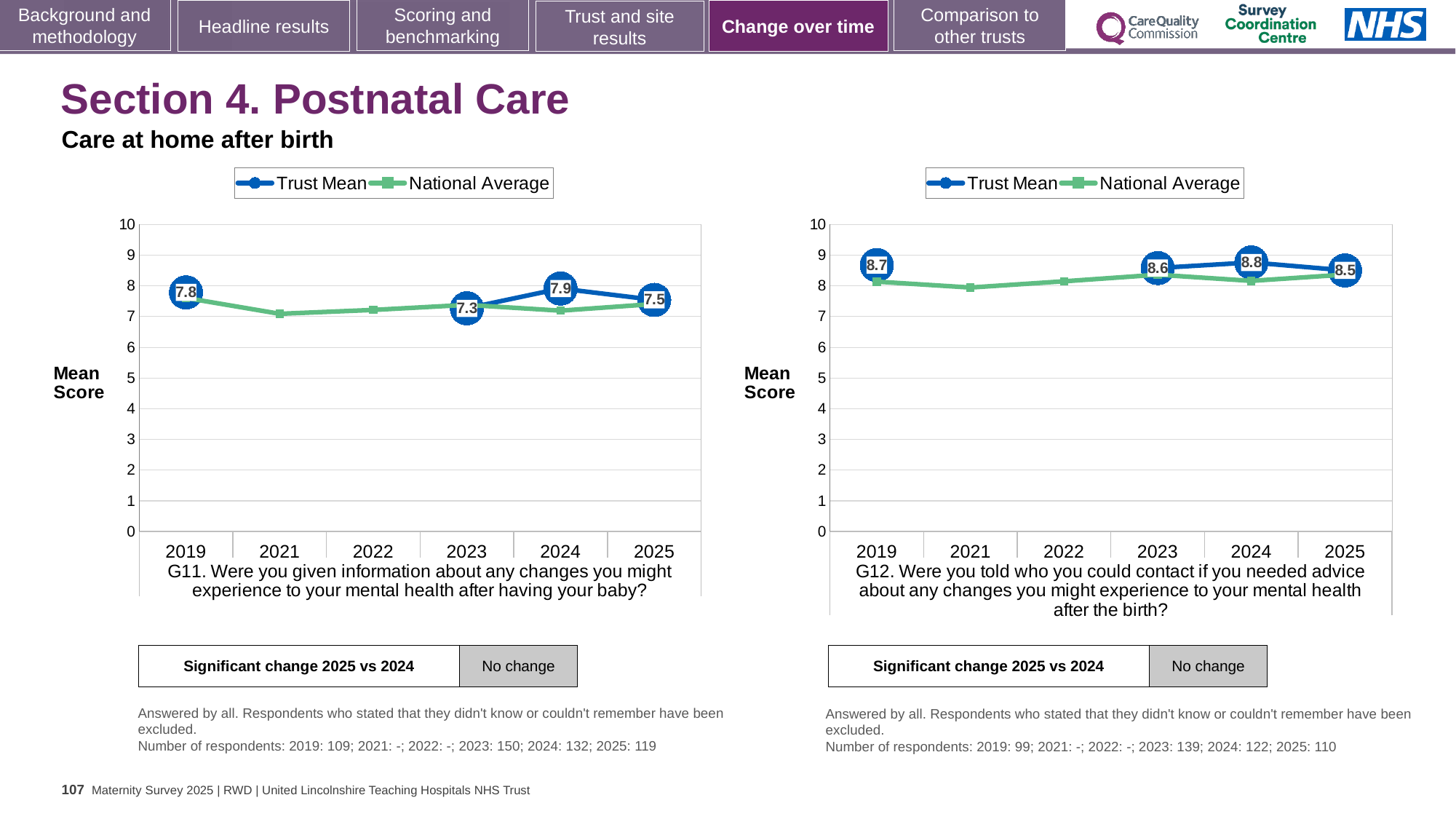
On the G11 chart (left), is the National Average for 2021 greater or less than 8? less On the G12 chart (right), what is the Trust Mean score for 2025? 8.5 On the G11 chart (left), what is the Trust Mean score for 2019? 7.8 On the G11 chart (left), in which year is the Trust Mean lowest? 2023 On the G12 chart (right), what is the Trust Mean score for 2024? 8.8 On the G11 chart (left), what is the Trust Mean score for 2023? 7.3 On the G11 chart (left), in which year is the Trust Mean highest? 2024 How many years are shown on the x axis of the G12 chart (right)? 6 What kind of chart is the G12 chart (right)? Line chart How many series does the legend of the G11 chart (left) list? 2 On the G12 chart (right), what is the difference between the Trust Mean in 2024 and in 2025? 0.3 On the G12 chart (right), which is larger: the Trust Mean in 2019 or in 2023? 2019